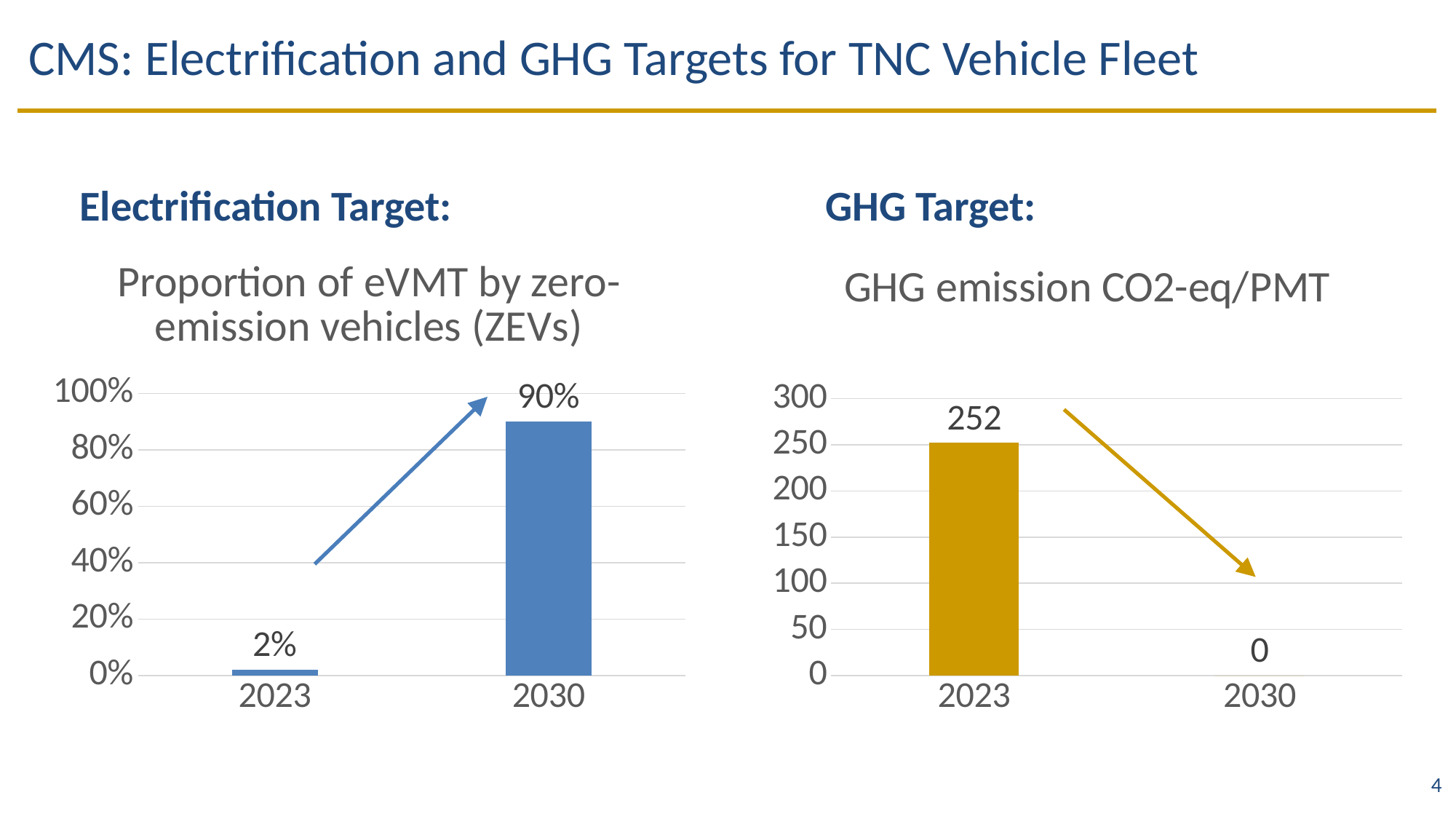
What kind of chart is the 'GHG emission CO2-eq/PMT' chart? Bar chart In the 'GHG emission CO2-eq/PMT' chart, what is the value for 2030? 0 In the 'GHG emission CO2-eq/PMT' chart, which year has the lowest value? 2030 In the 'GHG emission CO2-eq/PMT' chart, do the values rise or fall from 2023 to 2030? Fall In the 'GHG emission CO2-eq/PMT' chart, what is the value for 2023? 252 How many categories are shown on the x axis of the 'Proportion of eVMT by zero-emission vehicles (ZEVs)' chart? 2 In the 'Proportion of eVMT by zero-emission vehicles (ZEVs)' chart, what is the value for 2023? 2% In the 'Proportion of eVMT by zero-emission vehicles (ZEVs)' chart, what is the difference between the 2030 and 2023 values? 88% In the 'GHG emission CO2-eq/PMT' chart, what is the difference between the 2023 and 2030 values? 252 In the 'Proportion of eVMT by zero-emission vehicles (ZEVs)' chart, what is the value for 2030? 90% In the 'GHG emission CO2-eq/PMT' chart, is the value for 2023 greater or less than 200? greater In the 'Proportion of eVMT by zero-emission vehicles (ZEVs)' chart, which year has the highest value? 2030